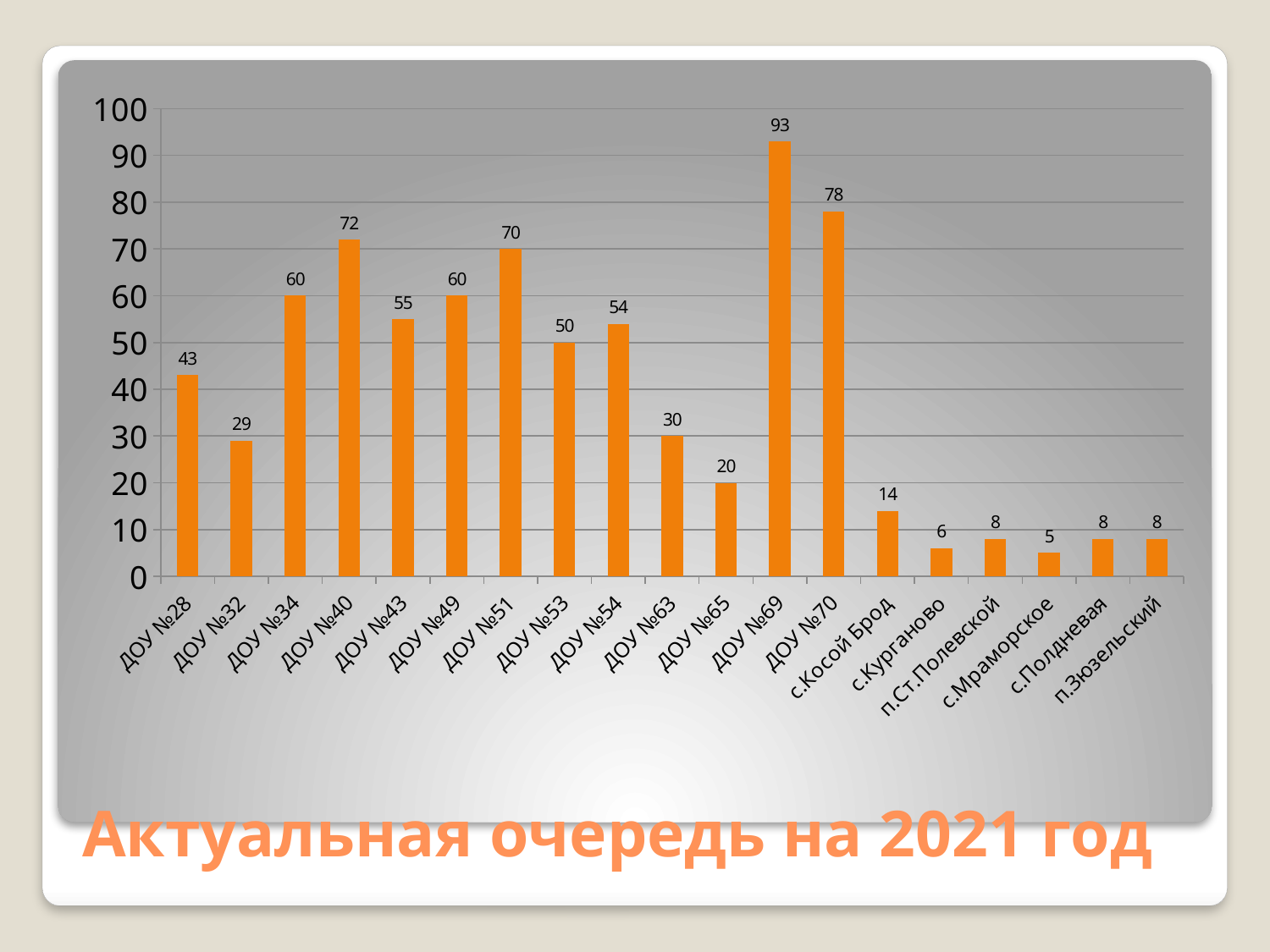
Which category has the lowest value? с.Мраморское Which category has the highest value? ДОУ №69 Is the value for ДОУ №63 greater or less than 40? less What is the value for с.Косой Брод? 14 What is the difference between the values for ДОУ №40 and ДОУ №32? 43 What is the value for ДОУ №43? 55 What is the difference between the values for ДОУ №69 and ДОУ №70? 15 Which is larger, the value for ДОУ №51 or the value for ДОУ №53? ДОУ №51 What kind of chart is shown on the slide? bar chart What is the value for ДОУ №69? 93 How many categories are shown on the x axis? 19 What is the title of the slide? Актуальная очередь на 2021 год